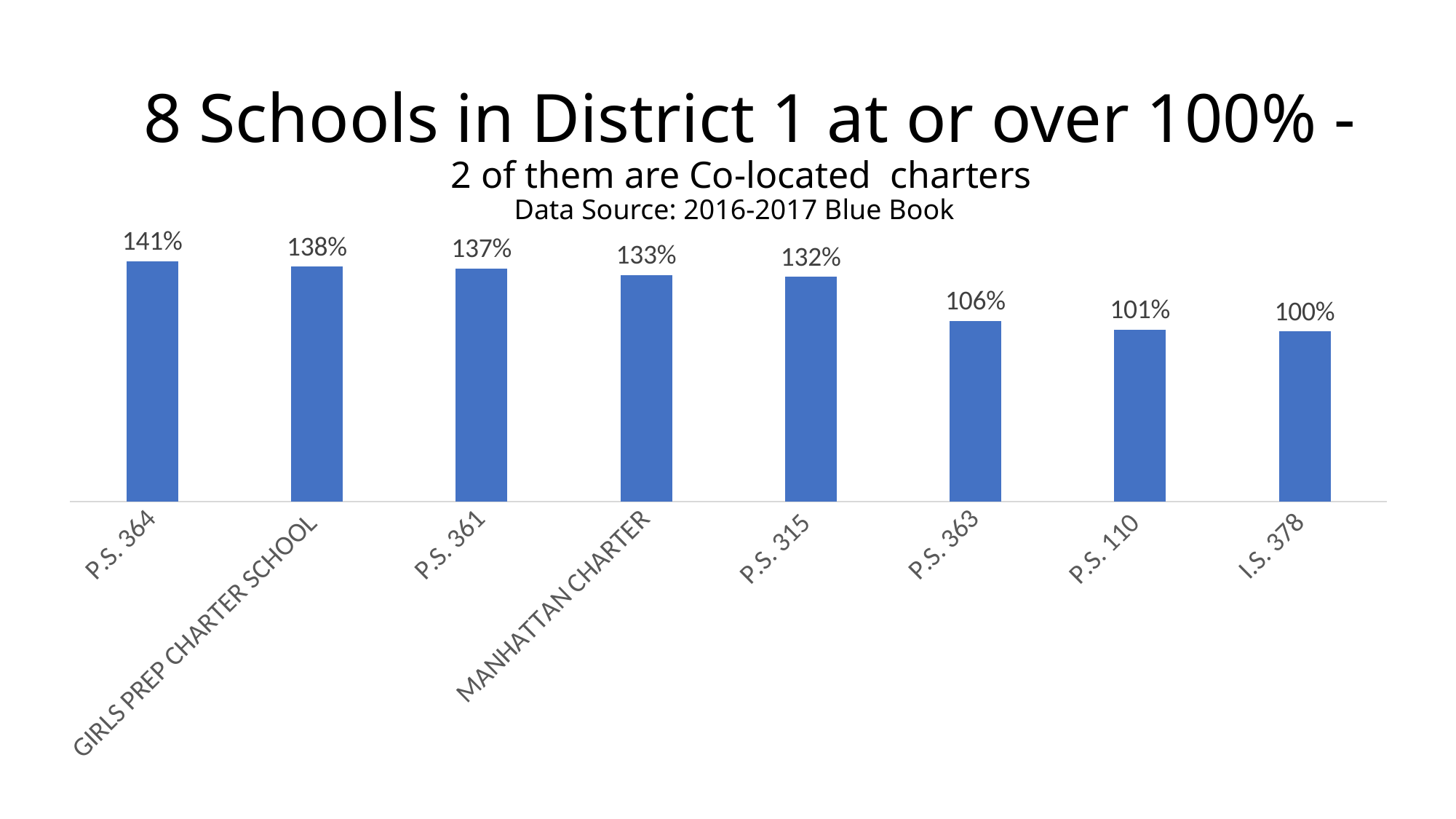
Which is larger, the value for P.S. 361 or the value for P.S. 110? P.S. 361 What is the value for P.S. 364? 141% Which school has the lowest value? I.S. 378 What is the difference between the values for P.S. 315 and P.S. 363? 26% What is the difference between the values for P.S. 364 and I.S. 378? 41% Do the values rise or fall from left to right across the chart? Fall What is the value for Girls Prep Charter School? 138% How many schools are shown in the chart? 8 Which school has the highest value? P.S. 364 What kind of chart is shown on the slide? Bar chart What is the value for Manhattan Charter? 133% What is the value for I.S. 378? 100%